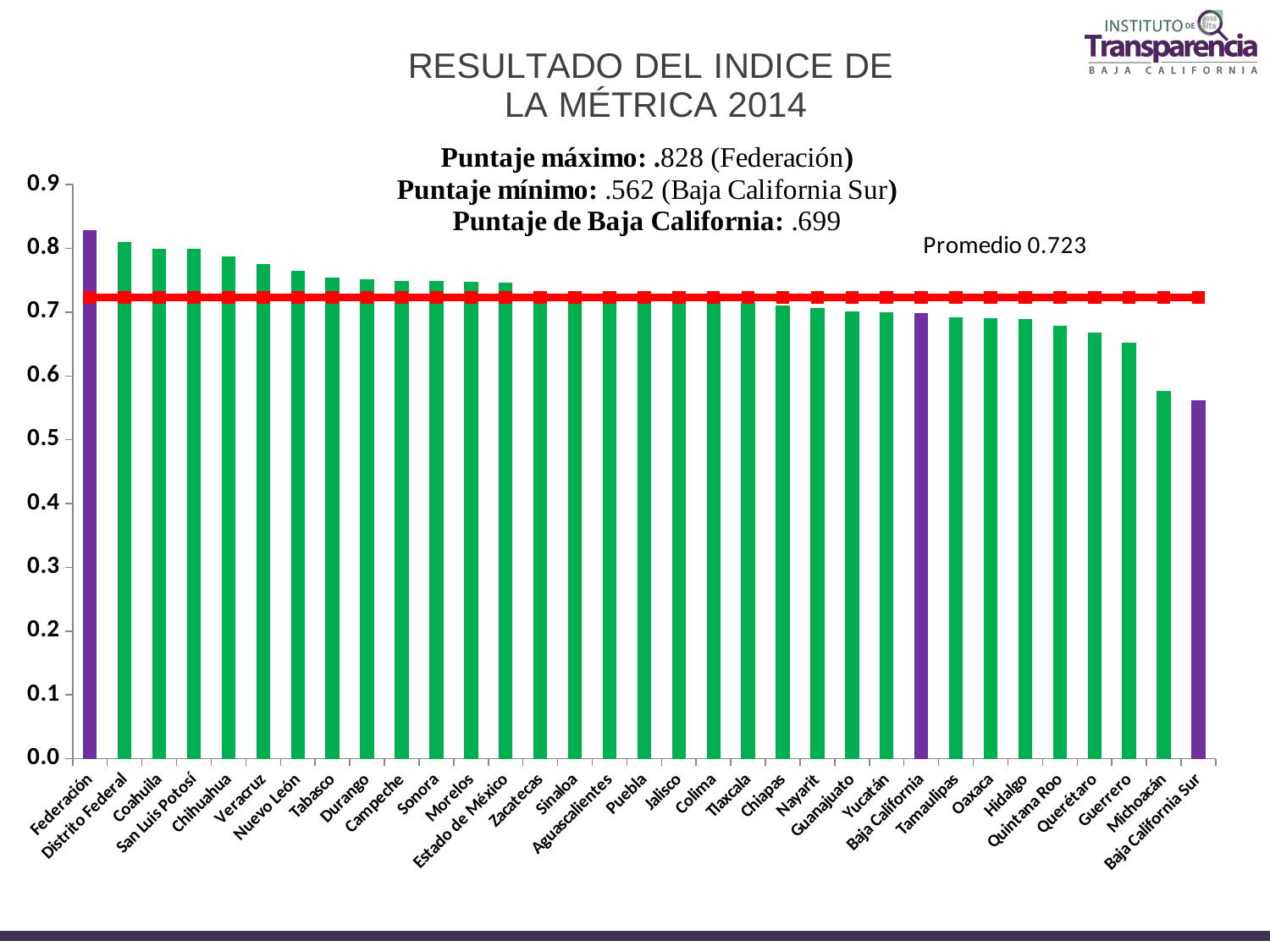
Is the value for Guerrero greater or less than 0.6? greater Do the bar values rise or fall from left to right along the x axis? fall Which category has the highest value in the chart? Federación What is the value of the Promedio (average) line? 0.723 Which has a larger value, Distrito Federal or Guerrero? Distrito Federal What is the score for Federación? .828 What is the difference between the scores of Federación and Baja California Sur? .266 What kind of chart is shown on the slide? bar chart Is the value for Michoacán greater or less than 0.6? less What is the score for Baja California? .699 What is the score for Baja California Sur? .562 Which category has the lowest value in the chart? Baja California Sur